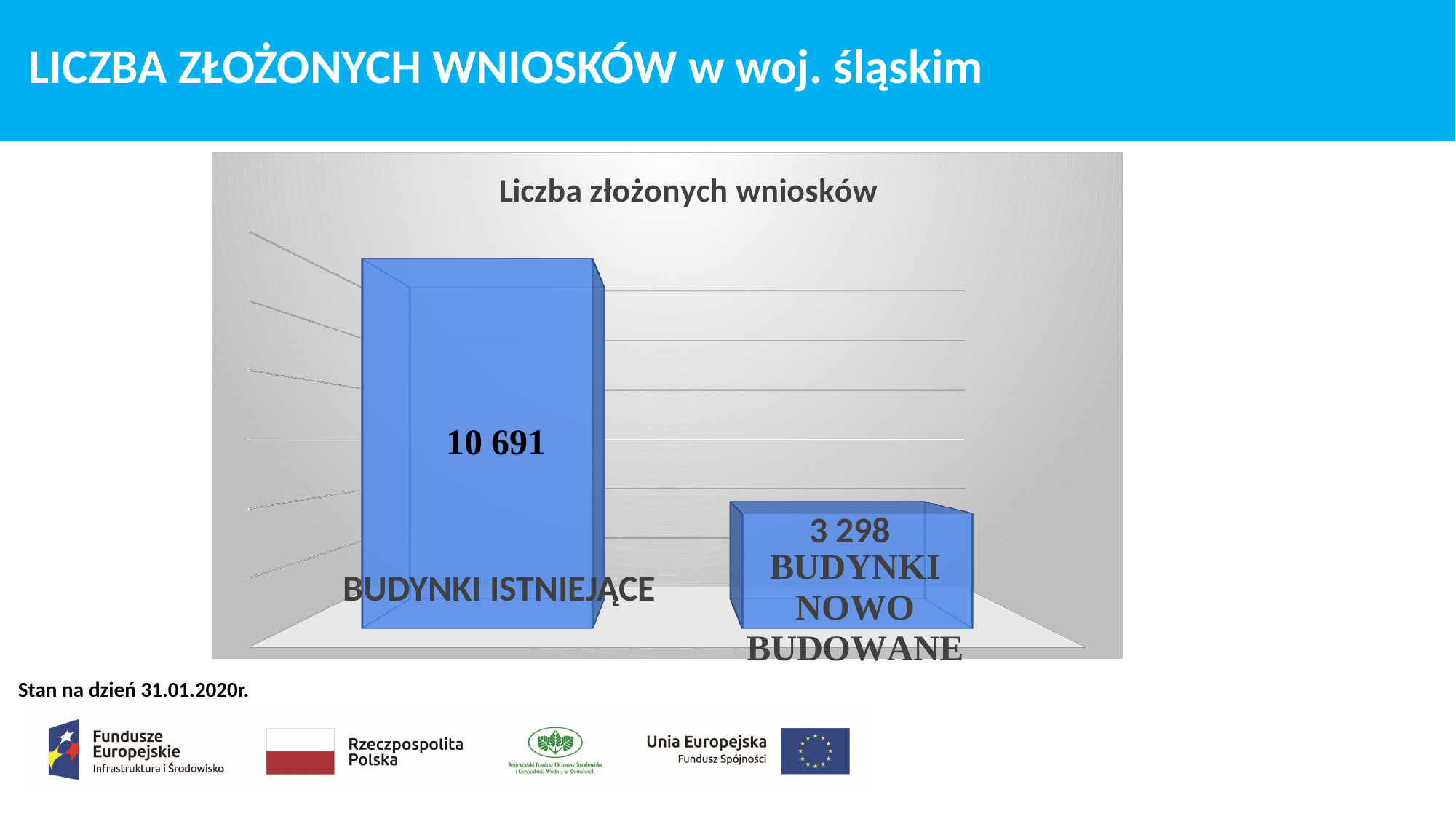
Which is larger, the value for BUDYNKI ISTNIEJĄCE or for BUDYNKI NOWO BUDOWANE? BUDYNKI ISTNIEJĄCE What is the value for BUDYNKI ISTNIEJĄCE? 10 691 What kind of chart is shown on the slide? bar chart Which category has the lowest value? BUDYNKI NOWO BUDOWANE What is the difference between the values for BUDYNKI ISTNIEJĄCE and BUDYNKI NOWO BUDOWANE? 7 393 What is the value for BUDYNKI NOWO BUDOWANE? 3 298 Which category has the highest value? BUDYNKI ISTNIEJĄCE What colour are the bars in the chart? blue What is the title of the chart? Liczba złożonych wniosków How many categories are shown in the chart? 2